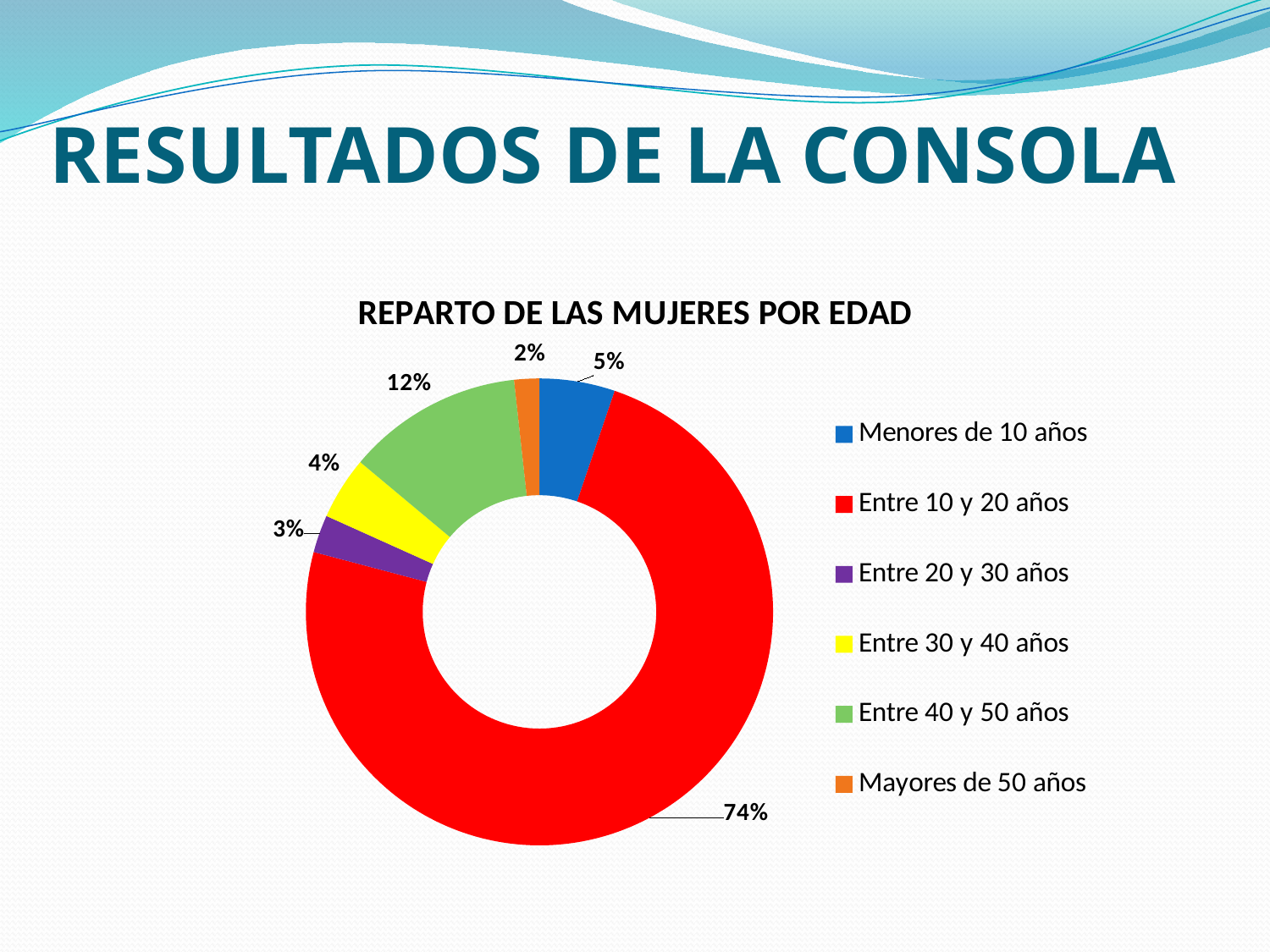
What percentage is shown for 'Mayores de 50 años'? 2% What colour represents 'Entre 30 y 40 años' in the chart? Yellow How many age categories does the chart show? 6 What percentage of the chart corresponds to 'Entre 10 y 20 años'? 74% What is the difference in percentage points between 'Entre 40 y 50 años' and 'Entre 30 y 40 años'? 8 What is the title of the chart? REPARTO DE LAS MUJERES POR EDAD Which is larger: the share for 'Entre 20 y 30 años' or for 'Entre 30 y 40 años'? Entre 30 y 40 años What percentage is shown for 'Menores de 10 años'? 5% Which age group has the largest share of the chart? Entre 10 y 20 años What type of chart is shown on the slide? Doughnut (pie) chart What percentage is shown for 'Entre 40 y 50 años'? 12% Which age group has the smallest share of the chart? Mayores de 50 años